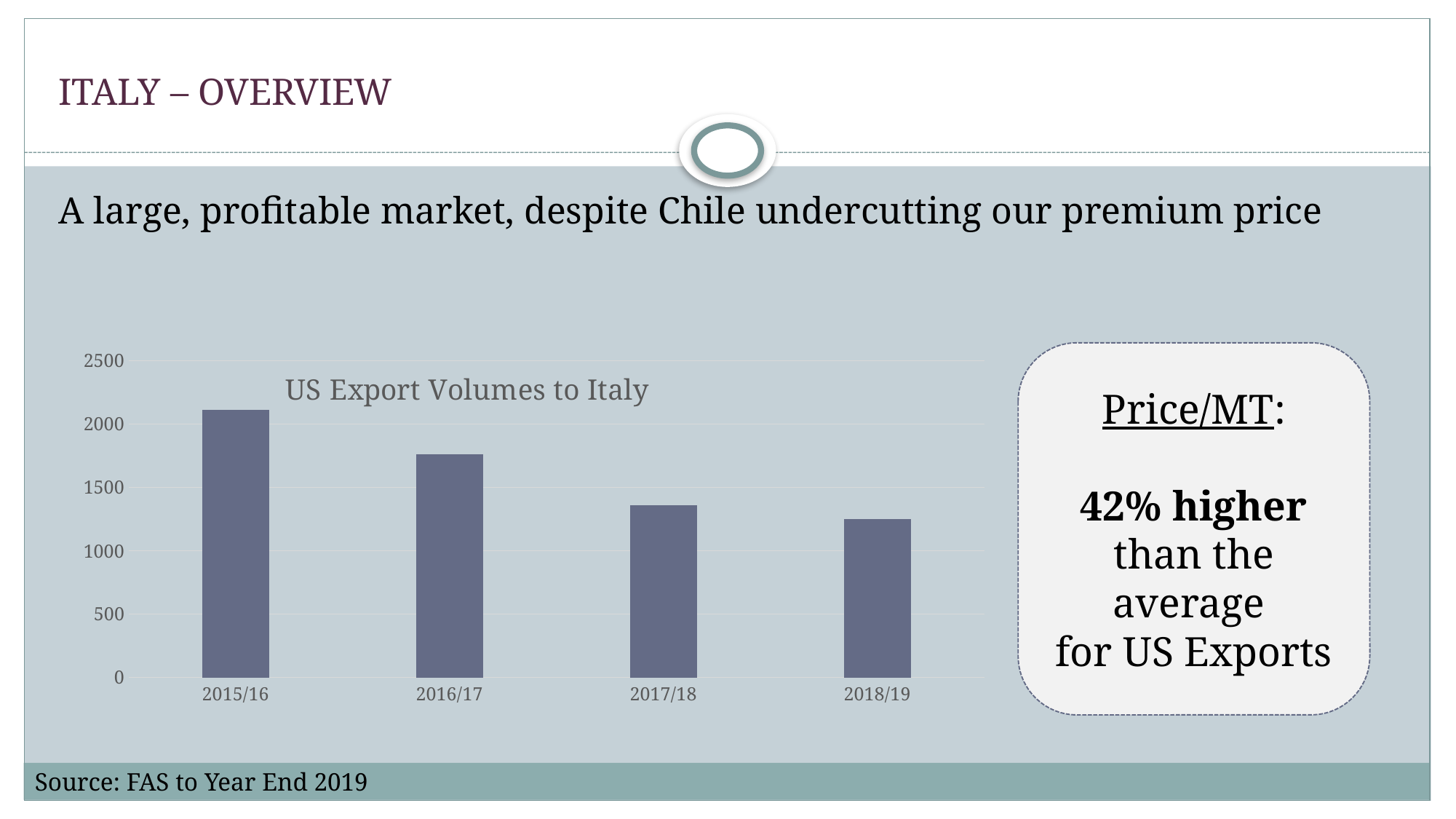
Is the value for 2015/16 greater or less than 2000? greater Is the value for 2017/18 greater or less than 1500? less Is the value for 2018/19 greater or less than 1000? greater Do the US export volumes to Italy rise or fall from 2015/16 to 2018/19? fall What kind of chart is shown on the slide? bar chart What is the source cited for the chart data? FAS to Year End 2019 What is the title of the chart? US Export Volumes to Italy Which is larger, the value for 2016/17 or the value for 2017/18? 2016/17 Which year has the highest US export volume to Italy? 2015/16 Which year has the lowest US export volume to Italy? 2018/19 How many categories are shown on the x axis of the chart? 4